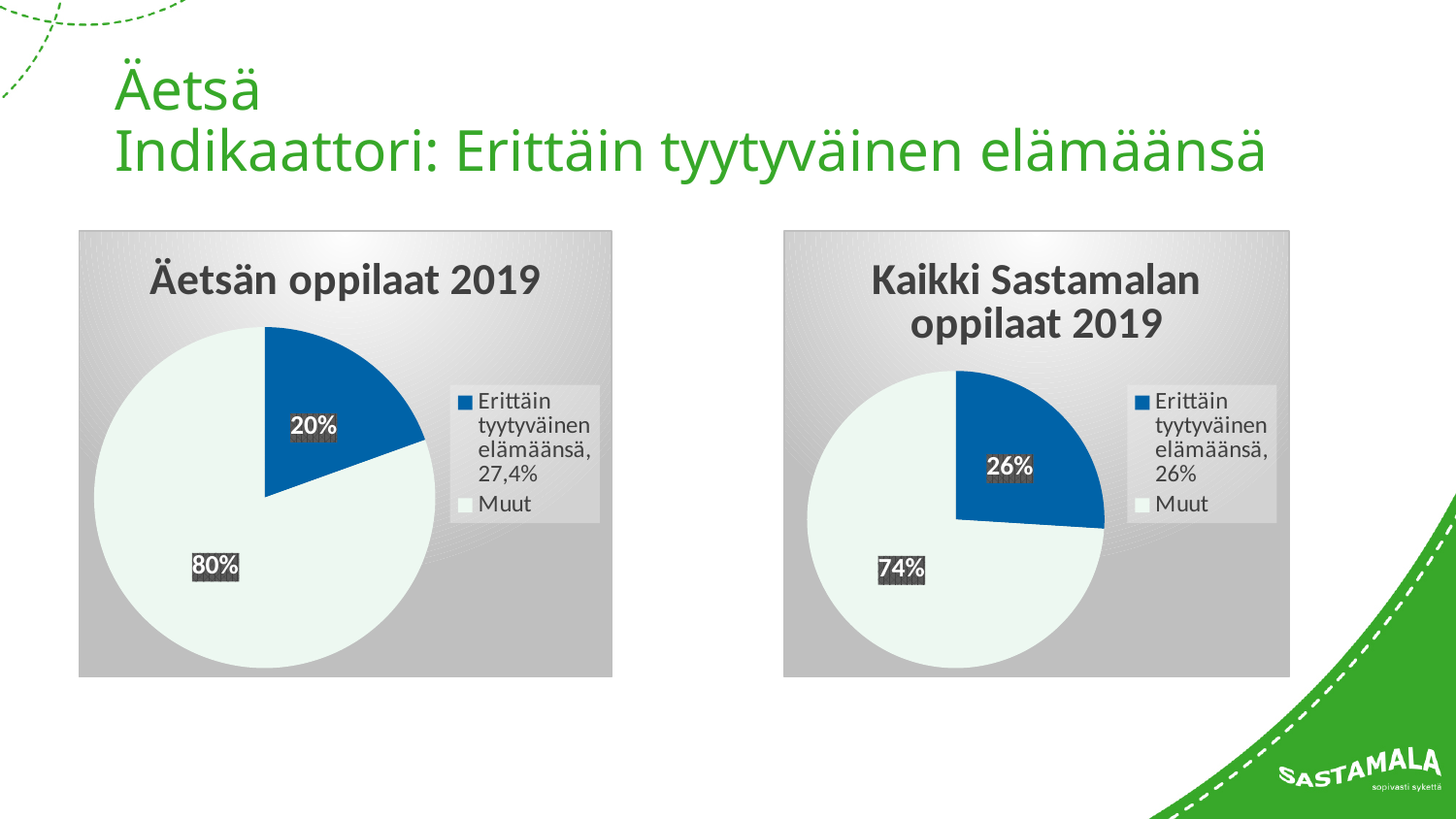
In the chart titled "Kaikki Sastamalan oppilaat 2019", what colour is the "Erittäin tyytyväinen elämäänsä" slice? Blue How many entries does the legend of the chart titled "Äetsän oppilaat 2019" list? 2 In the chart titled "Äetsän oppilaat 2019", which slice is the smallest? Erittäin tyytyväinen elämäänsä In the chart titled "Kaikki Sastamalan oppilaat 2019", what is the difference between the "Muut" slice and the "Erittäin tyytyväinen elämäänsä" slice? 48% In the chart titled "Äetsän oppilaat 2019", what percentage is shown for the "Muut" slice? 80% In the chart titled "Kaikki Sastamalan oppilaat 2019", what percentage is shown for the "Muut" slice? 74% Which chart shows a larger "Erittäin tyytyväinen elämäänsä" slice label: "Äetsän oppilaat 2019" or "Kaikki Sastamalan oppilaat 2019"? Kaikki Sastamalan oppilaat 2019 In the chart titled "Äetsän oppilaat 2019", what percentage label is shown on the blue "Erittäin tyytyväinen elämäänsä" slice? 20% In the chart titled "Kaikki Sastamalan oppilaat 2019", which slice is the largest? Muut How many slices does the chart titled "Kaikki Sastamalan oppilaat 2019" have? 2 In the chart titled "Kaikki Sastamalan oppilaat 2019", what percentage is shown for "Erittäin tyytyväinen elämäänsä"? 26% What type of chart is the left chart, "Äetsän oppilaat 2019"? Pie chart